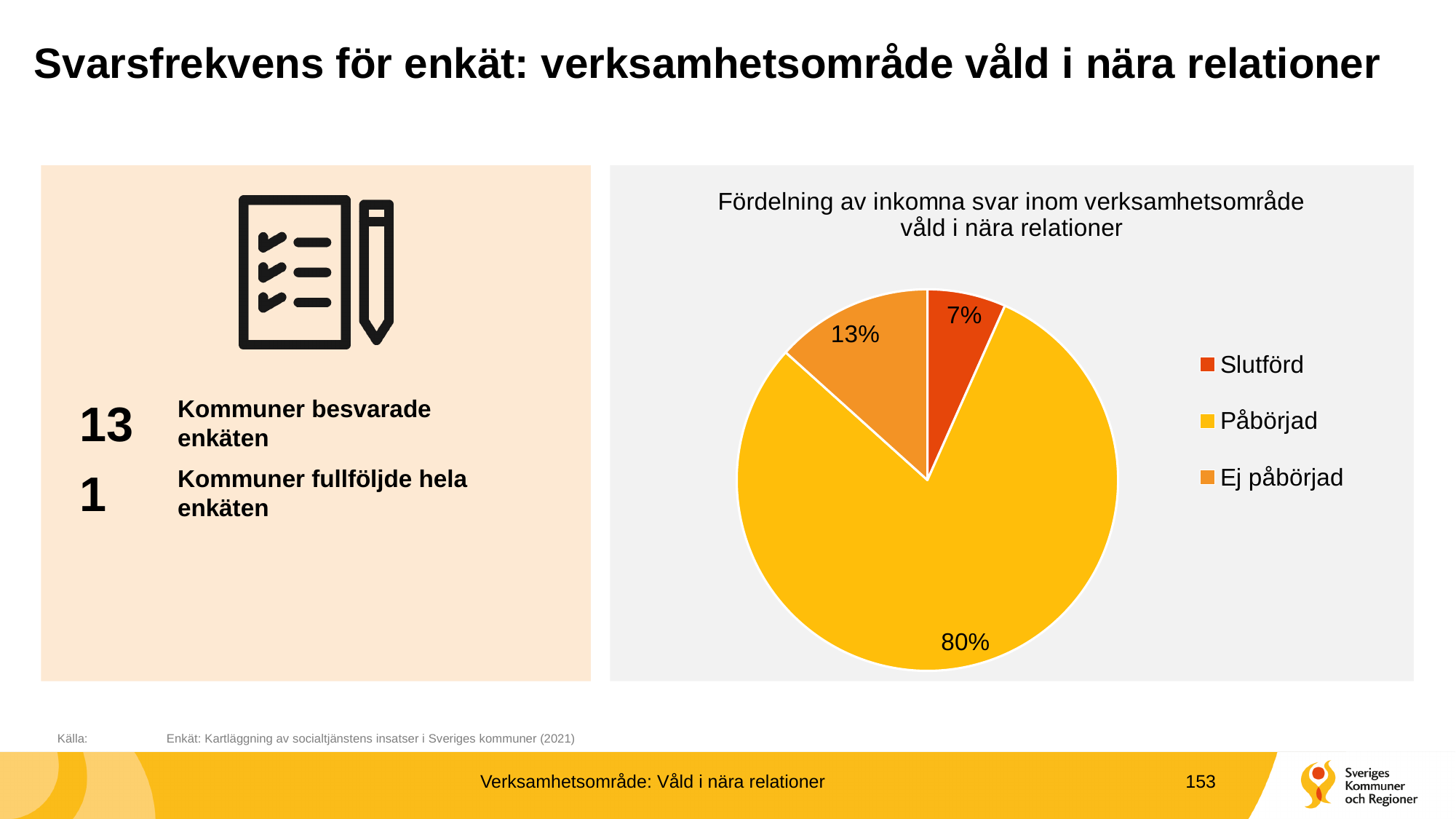
What share of the pie does Slutförd represent? 7% How many categories does the pie chart show? 3 What is the difference in percentage points between Påbörjad and Ej påbörjad? 67 What kind of chart is shown on the slide? Pie chart What is the difference in percentage points between Ej påbörjad and Slutförd? 6 What share of the pie does Ej påbörjad represent? 13% Which category has the largest slice of the pie? Påbörjad Which colour represents Slutförd in the legend? Red What is the title of the chart? Fördelning av inkomna svar inom verksamhetsområde våld i nära relationer What share of the pie does Påbörjad represent? 80% Which is larger, the share for Ej påbörjad or the share for Slutförd? Ej påbörjad Which category has the smallest slice of the pie? Slutförd